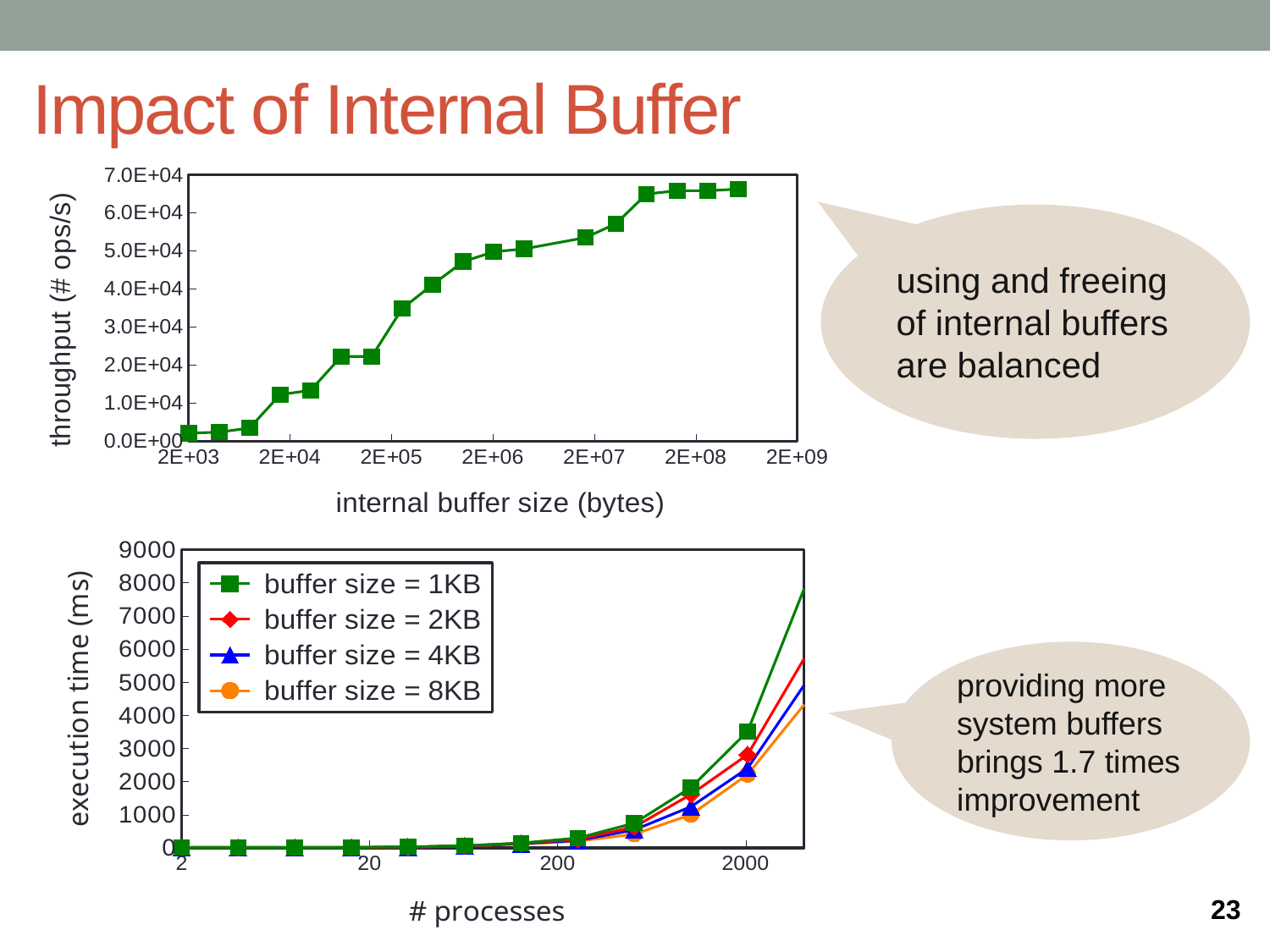
In the bottom chart, which buffer size series has the highest execution time at 2000 processes? buffer size = 1KB How many series does the legend of the bottom chart (execution time vs # processes) list? 4 What kind of chart is the bottom chart (execution time vs # processes)? line chart In the bottom chart, is the execution time for buffer size = 1KB at 2000 processes greater or less than 3000? greater In the top chart, does throughput rise or fall as internal buffer size increases? rise In the bottom chart, does execution time rise or fall as the number of processes increases? rise What is the x-axis label of the top chart? internal buffer size (bytes) What kind of chart is the top chart (throughput vs internal buffer size)? line chart In the bottom chart, which buffer size series has the lowest execution time at 2000 processes? buffer size = 8KB In the top chart, is the throughput at an internal buffer size of 2E+03 bytes greater or less than 1.0E+04? less In the top chart, is the throughput at an internal buffer size of 2E+08 bytes greater or less than 6.0E+04? greater